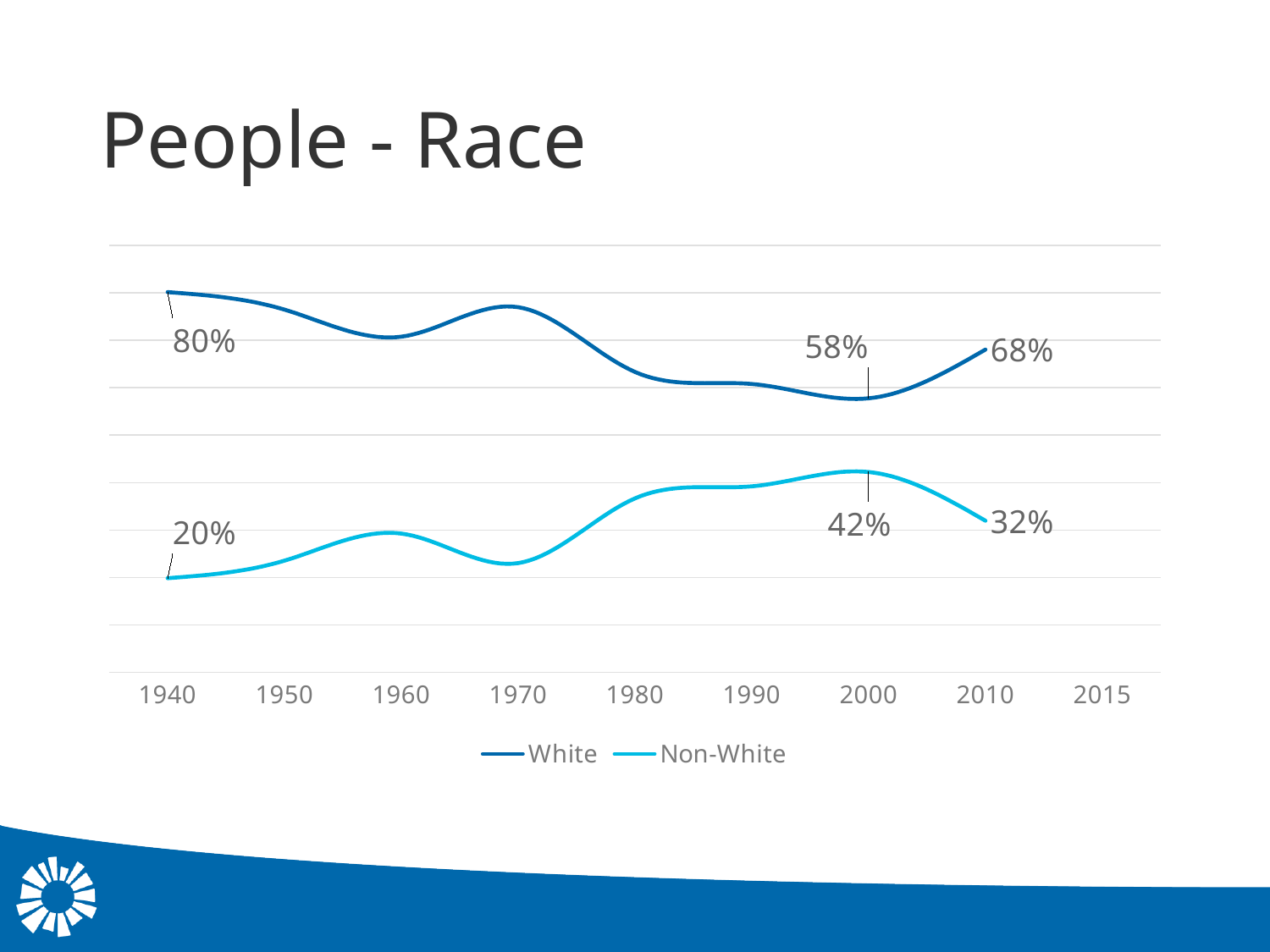
What is the value for Non-White in 2000? 42% What is the title of the slide containing the chart? People - Race How many series does the legend list? 2 What is the value for White in 1940? 80% Which series has the larger value in 2010, White or Non-White? White What is the value for Non-White in 1940? 20% What type of chart is shown on the slide? line chart What is the value for Non-White in 2010? 32% What is the value for White in 2010? 68% What is the value for White in 2000? 58% What is the difference between the White and Non-White values in 2000? 16% Does the Non-White line rise or fall between 1940 and 2000? rise